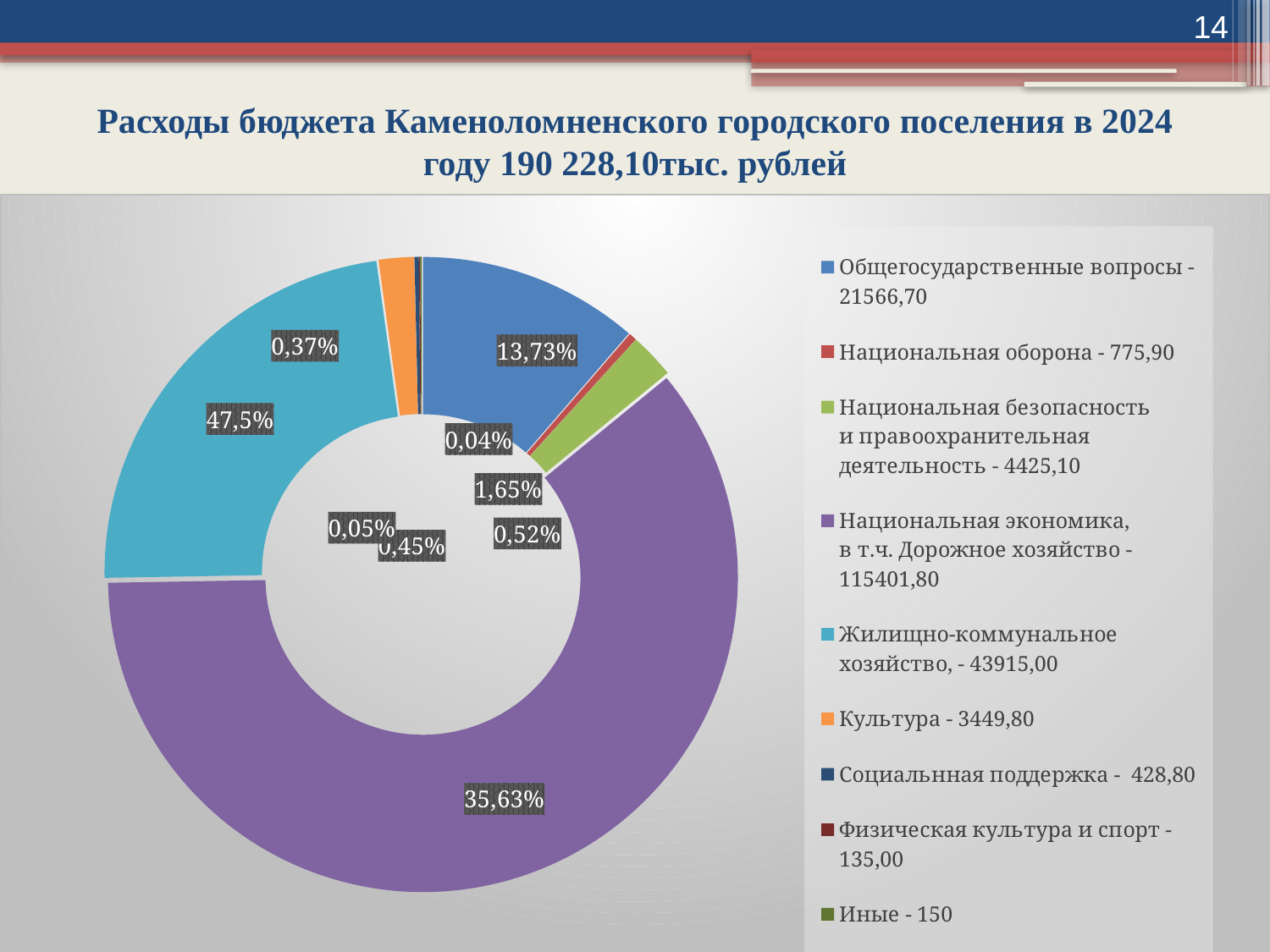
How many categories does the legend list? 9 What kind of chart is shown on the slide? Doughnut (pie) chart Which category has the smallest value in the legend? Физическая культура и спорт - 135,00 According to the legend, what is the value for Жилищно-коммунальное хозяйство? 43915,00 According to the legend, what is the value for Социальнная поддержка? 428,80 Which is larger: the value for Общегосударственные вопросы or the value for Национальная безопасность и правоохранительная деятельность? Общегосударственные вопросы Which category has the largest slice of the chart? Национальная экономика, в т.ч. Дорожное хозяйство According to the legend, what is the value for Национальная экономика, в т.ч. Дорожное хозяйство? 115401,80 What is the difference between the legend values for Жилищно-коммунальное хозяйство and Общегосударственные вопросы? 22348,30 According to the legend, what is the value for Культура? 3449,80 What percentage label is printed on the purple slice? 35,63% What total budget expenditure is stated in the chart title? 190 228,10 тыс. рублей